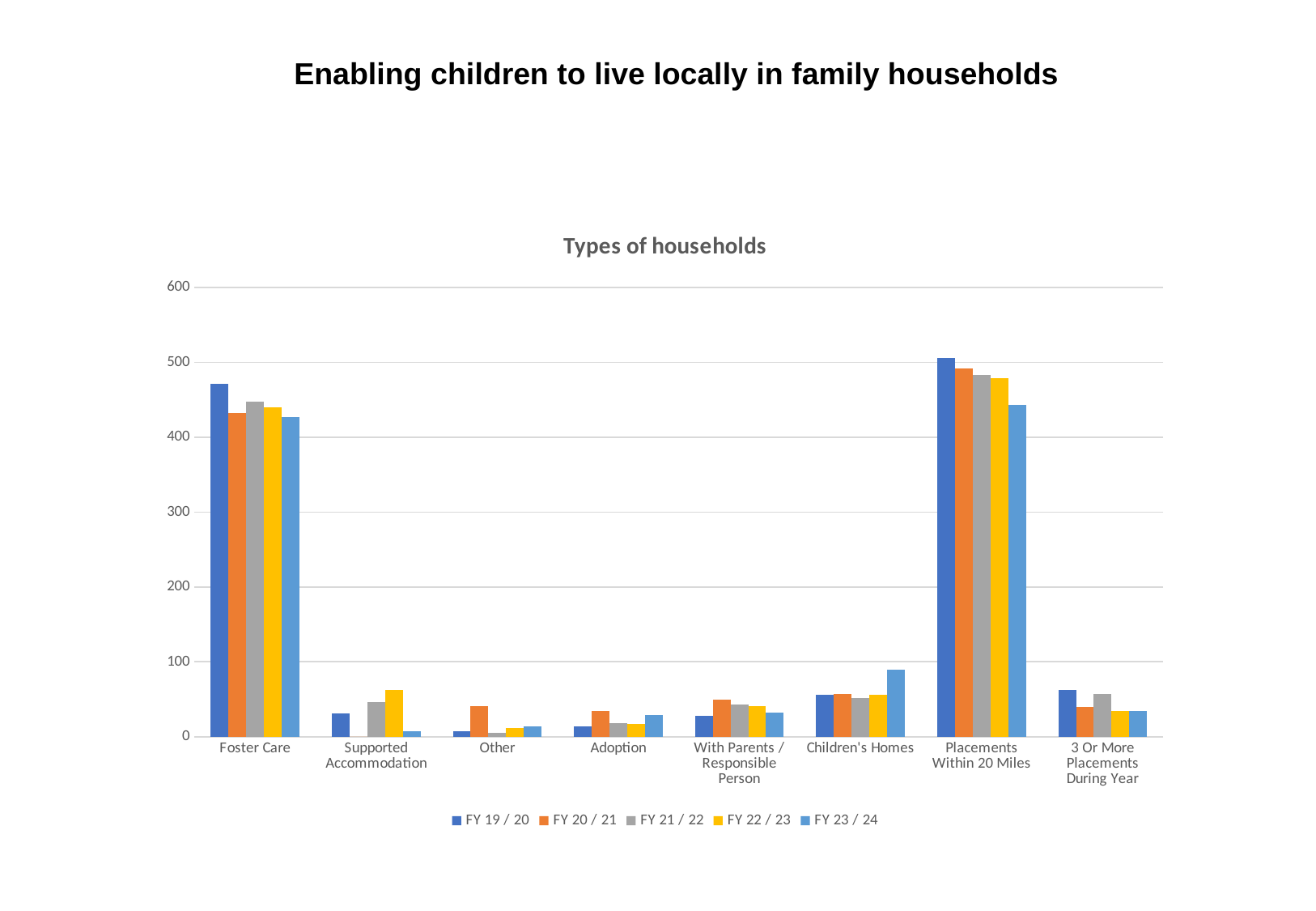
How many series does the legend list? 5 Is the value for Children's Homes in FY 23 / 24 greater or less than 100? less What is the title of the chart? Types of households Which category has the highest value for FY 19 / 20? Placements Within 20 Miles For Children's Homes, which is larger: the FY 19 / 20 value or the FY 23 / 24 value? FY 23 / 24 Is the value for Placements Within 20 Miles in FY 23 / 24 greater or less than 500? less Is the value for Foster Care in FY 19 / 20 greater or less than 400? greater What kind of chart is shown on the slide? bar chart For Foster Care, which is larger: the FY 19 / 20 value or the FY 23 / 24 value? FY 19 / 20 Which series has the highest value for Supported Accommodation? FY 22 / 23 How many categories are shown along the x axis? 8 Do the values for Placements Within 20 Miles rise or fall from FY 19 / 20 to FY 23 / 24? fall